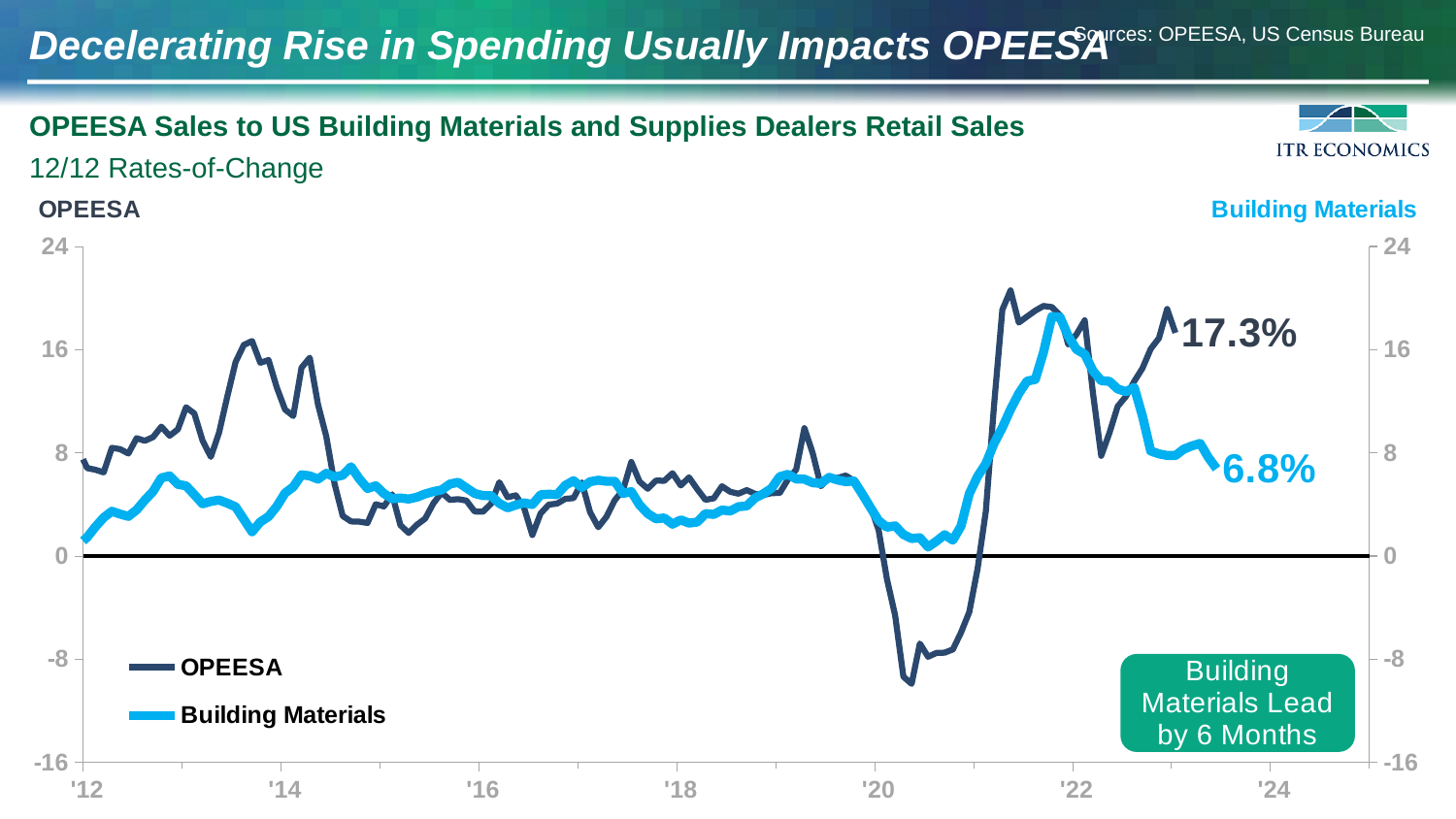
What is the latest labeled value for the Building Materials series? 6.8% What is the difference between the latest labeled OPEESA value and the latest labeled Building Materials value? 10.5 percentage points What kind of chart is shown on the slide? Line chart Does the OPEESA line rise or fall between its 2020 low and its 2021 peak? Rise Is the peak of the OPEESA line around 2021 greater or less than 16? greater What is the title of the chart? OPEESA Sales to US Building Materials and Supplies Dealers Retail Sales According to the callout box on the chart, by how many months do Building Materials lead? 6 months How many series does the legend list? 2 Is the lowest point of the OPEESA line around 2020 greater or less than -8? less Which series has the higher latest labeled value, OPEESA or Building Materials? OPEESA What is the latest labeled value for the OPEESA series? 17.3% Is the peak of the Building Materials line around 2022 greater or less than 16? greater